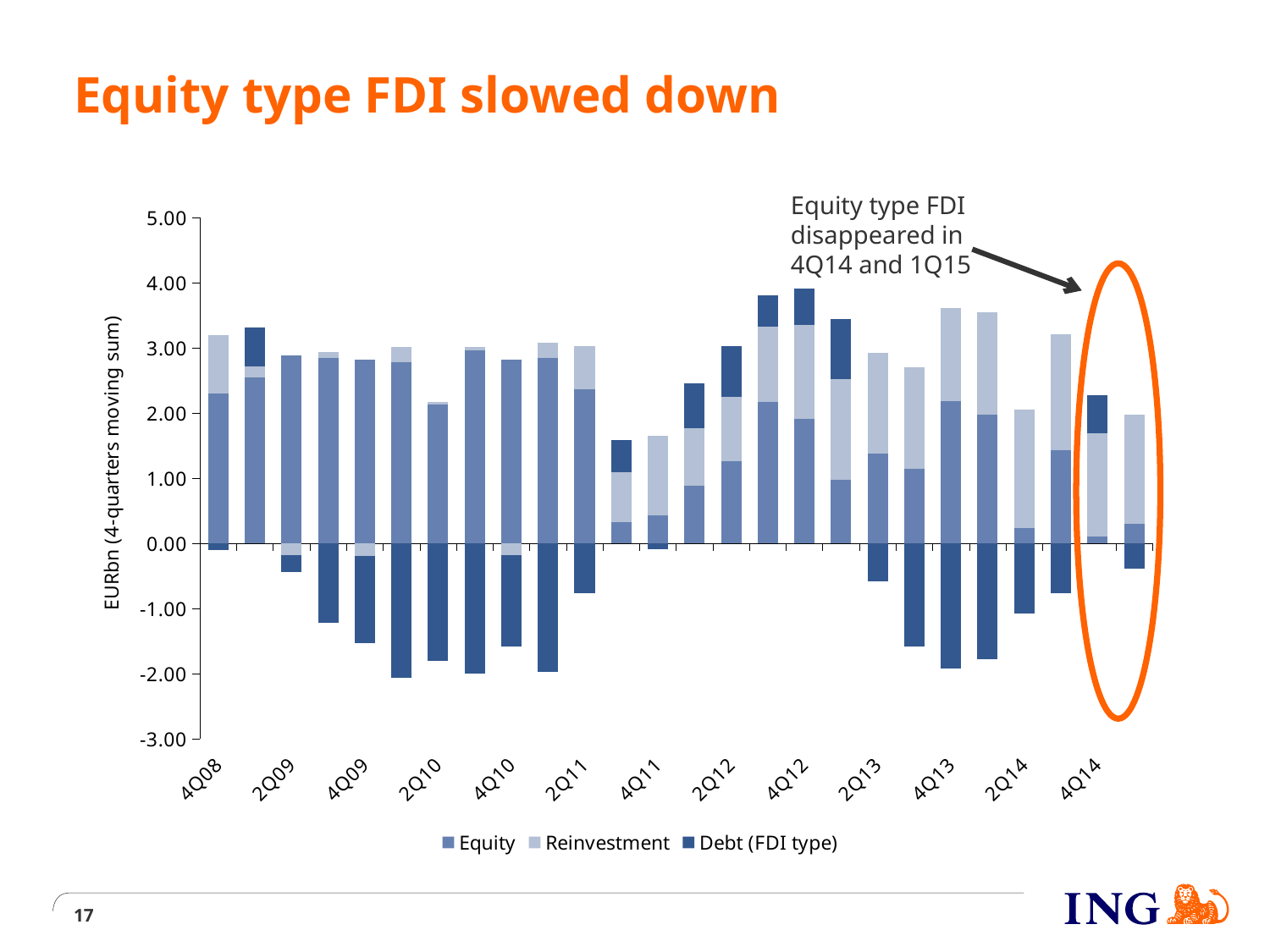
What is the label on the vertical axis? EURbn (4-quarters moving sum) How many series does the legend list? 3 Is the Equity value for 4Q08 greater or less than 2.00? greater Is the total of the stacked bar for 4Q11 greater or less than 2.00? less Which series are listed in the legend? Equity, Reinvestment, Debt (FDI type) Which is larger, the Equity value for 4Q08 or the Equity value for 4Q14? 4Q08 Is the total of the stacked bar for 4Q12 greater or less than 3.00? greater How many quarter labels are shown on the x axis? 13 What kind of chart is shown on the slide? Stacked bar chart